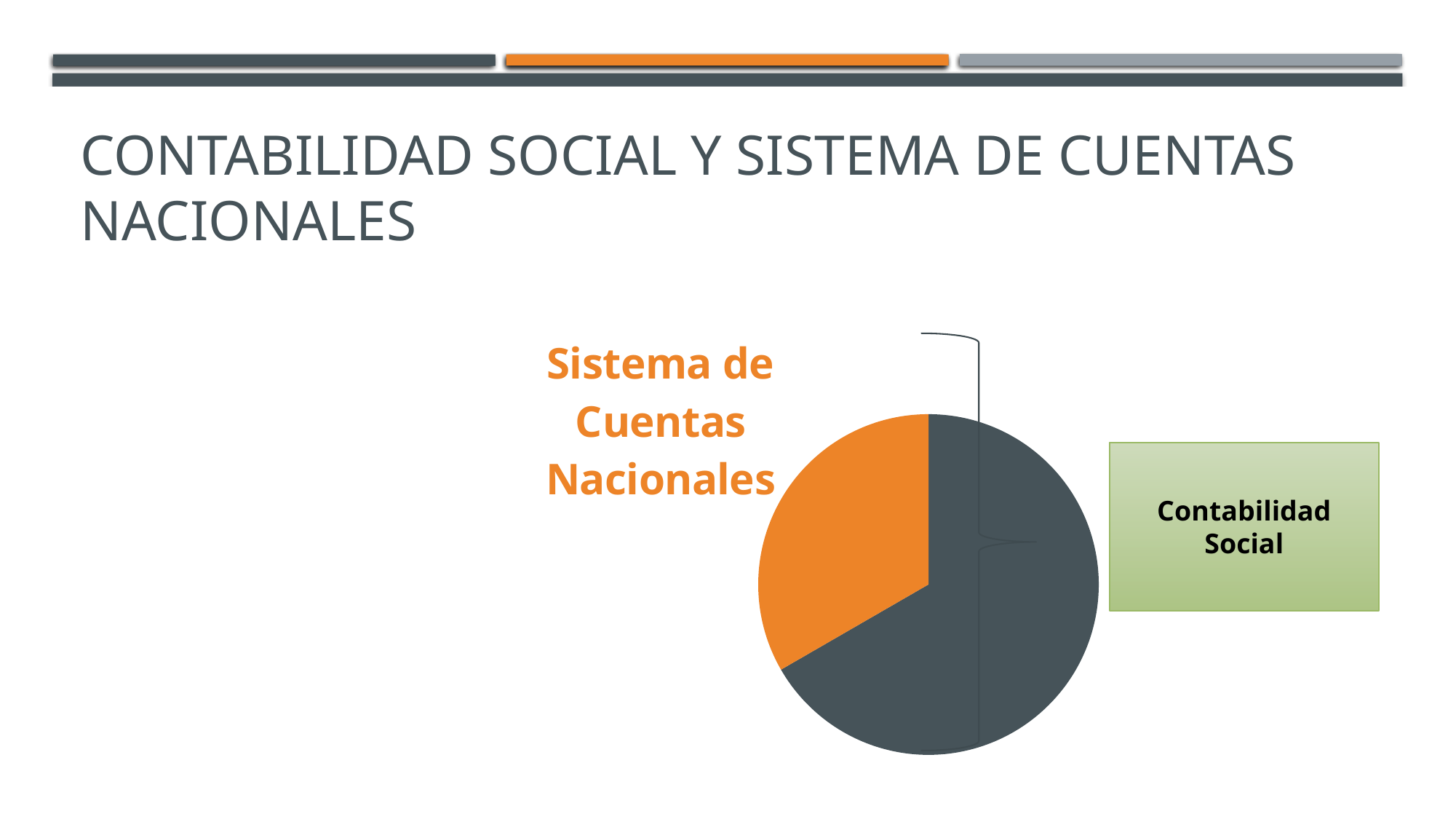
Which is larger in the pie chart, Contabilidad Social or Sistema de Cuentas Nacionales? Contabilidad Social What kind of chart is shown on the slide? Pie chart Which slice of the pie chart is the largest? Contabilidad Social What colour is the Sistema de Cuentas Nacionales slice of the pie chart? Orange How many slices does the pie chart have? 2 What colour is the Contabilidad Social slice of the pie chart? Dark grey Which slice of the pie chart is the smallest? Sistema de Cuentas Nacionales